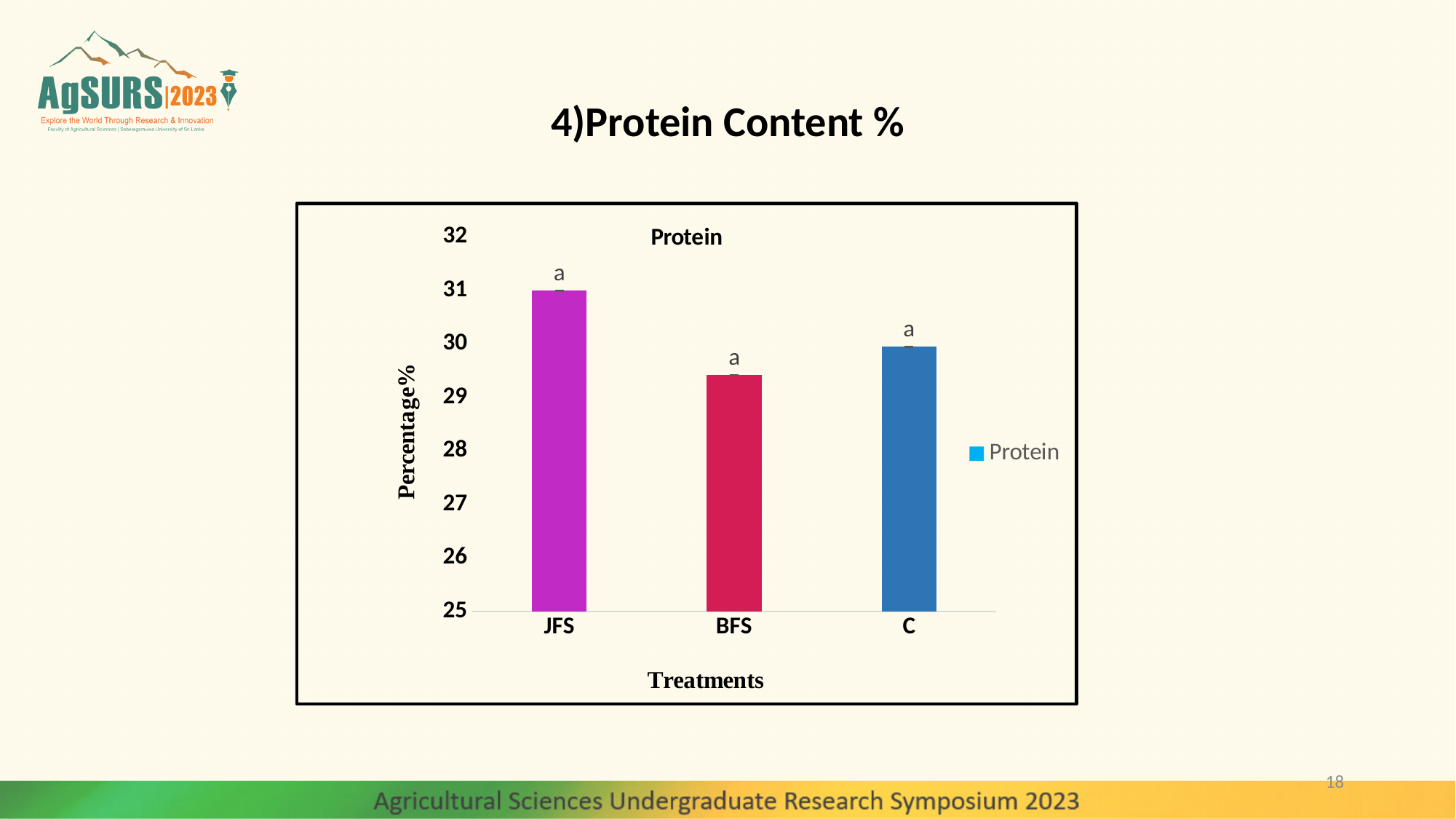
Which has a higher protein content, JFS or C? JFS Is the protein content for C greater or less than 29? greater Which treatment has the highest protein content? JFS Is the protein content for BFS greater or less than 30? less What is the title of the x axis of the chart? Treatments Is the protein content for JFS greater or less than 30? greater Which has a higher protein content, BFS or C? C What is the title of the y axis of the chart? Percentage% How many treatments are shown on the x axis of the chart? 3 How many series does the chart legend list? 1 Which treatment has the lowest protein content? BFS What kind of chart is shown on the slide? bar chart